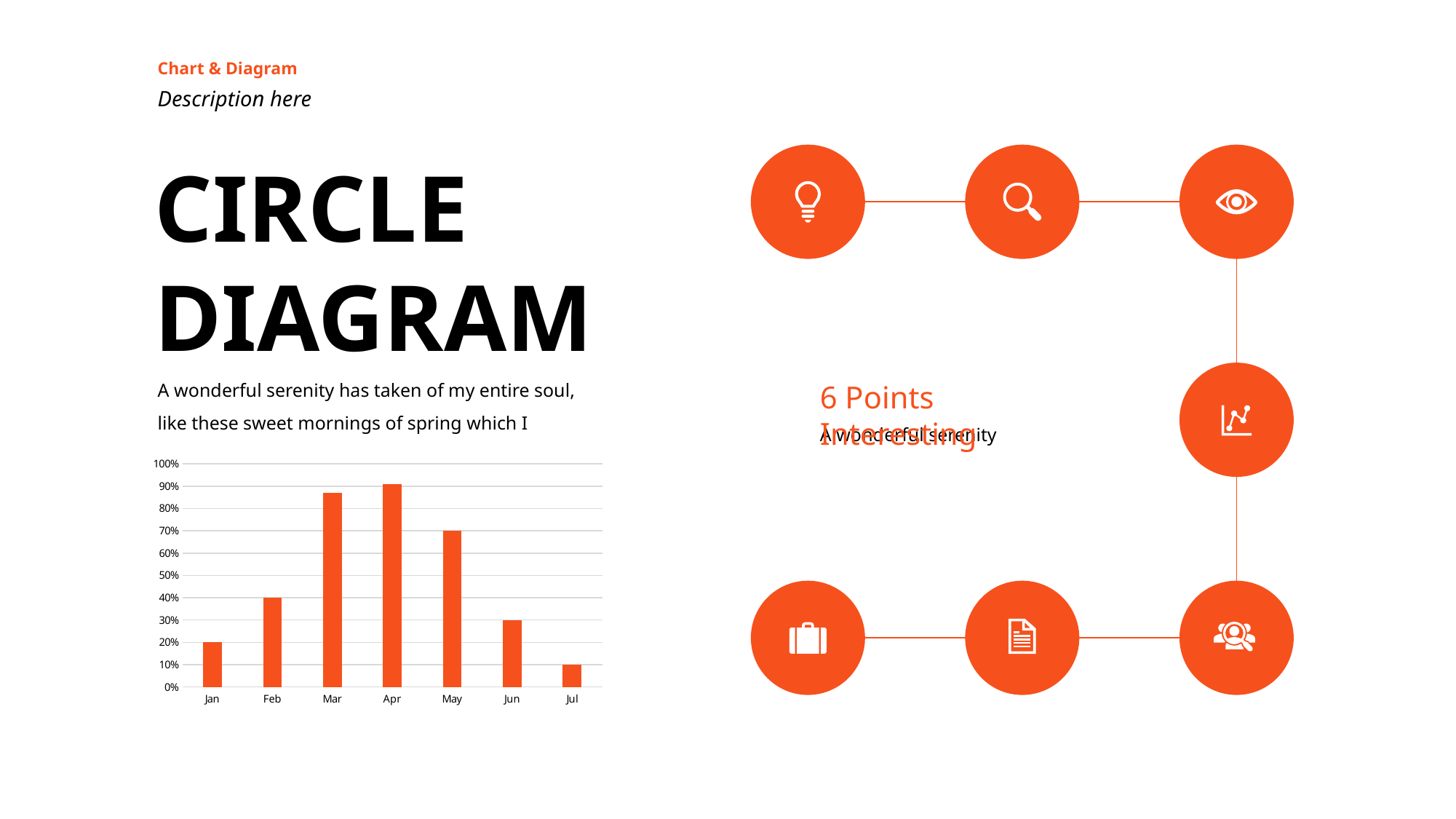
What is the value for Feb in the bar chart? 40% What is the value for May in the bar chart? 70% How many months are shown on the x axis of the bar chart? 7 What is the value for Jul in the bar chart? 10% Which is larger, the value for Feb or the value for Jun? Feb Is the value for Mar greater or less than 80%? greater What type of chart is shown on the slide? bar chart What is the difference between the values for May and Jun? 40% What is the value for Jan in the bar chart? 20% Which month has the highest bar in the chart? Apr Which month has the lowest bar in the chart? Jul